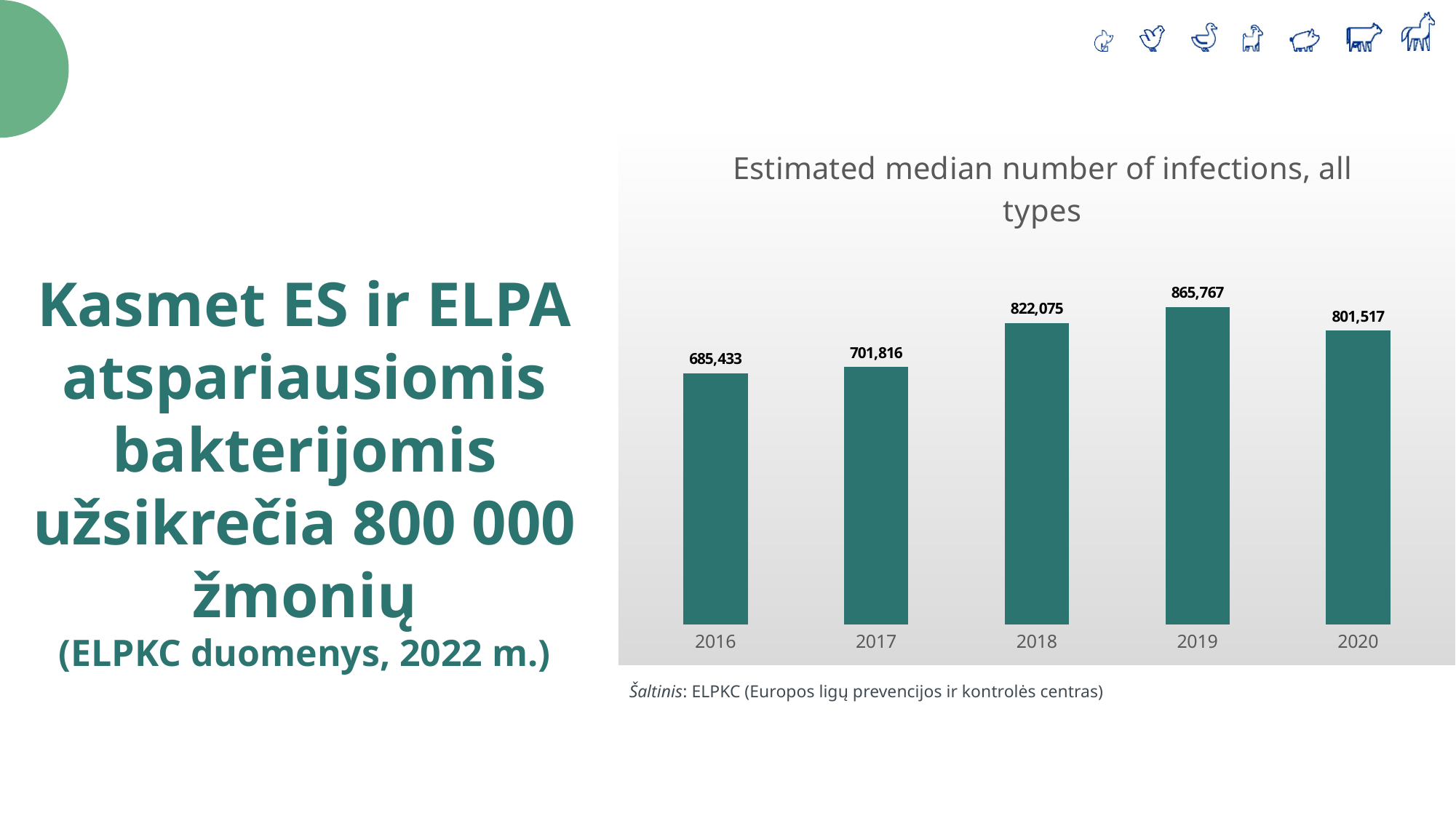
What is the estimated median number of infections for 2016? 685,433 What is the difference between the values for 2017 and 2016? 16,383 Do the values rise or fall from 2016 to 2019? Rise What kind of chart is shown on the slide? Bar chart What is the difference between the values for 2019 and 2018? 43,692 Which year has the highest estimated median number of infections? 2019 How many years are shown on the x axis of the chart? 5 What is the estimated median number of infections for 2018? 822,075 What is the estimated median number of infections for 2020? 801,517 What is the title of the chart? Estimated median number of infections, all types Which year has the lowest estimated median number of infections? 2016 Which year has a larger value, 2018 or 2020? 2018